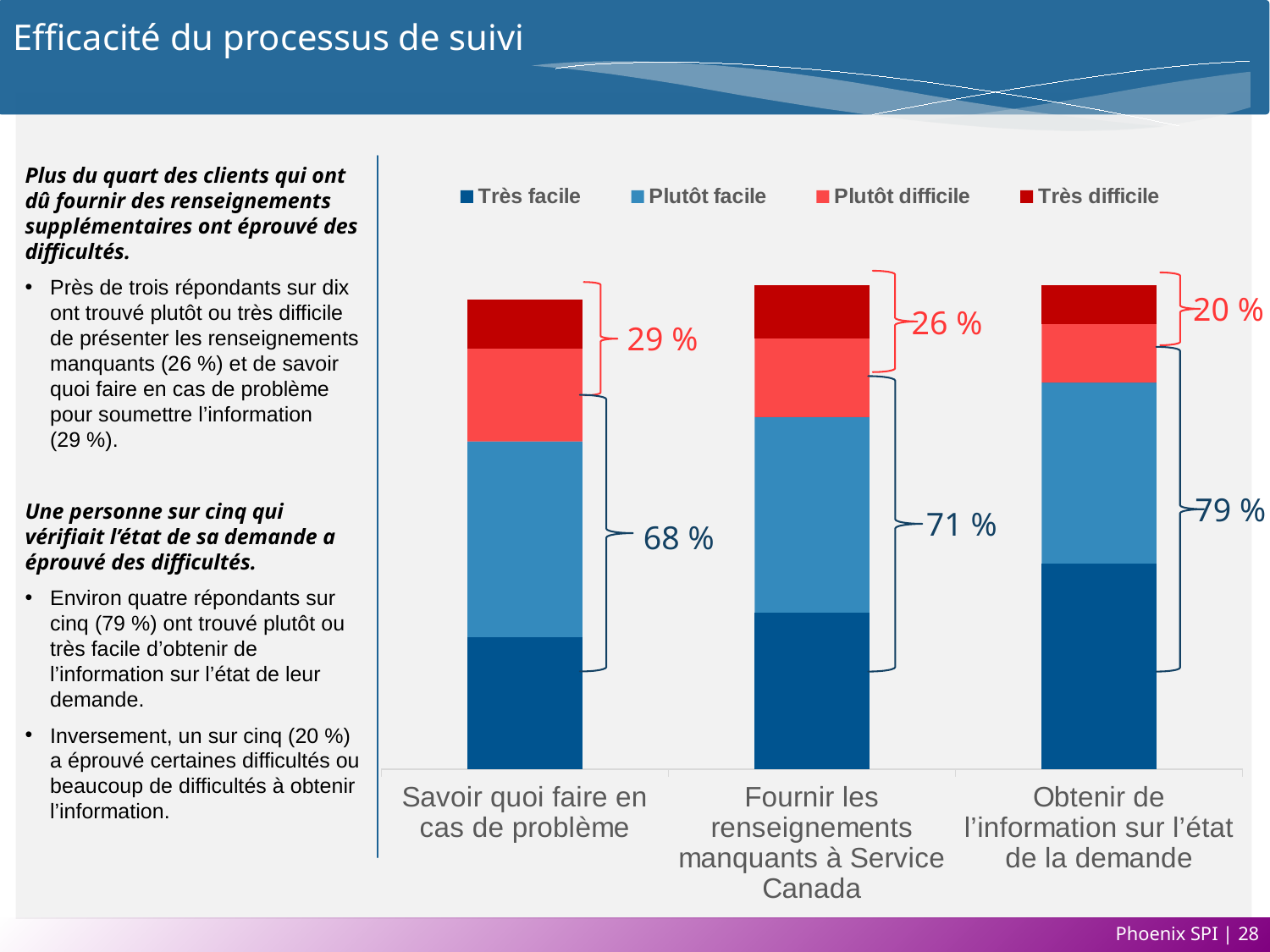
What combined percentage of respondents found it plutôt or très difficile to 'Savoir quoi faire en cas de problème'? 29 % Which legend entry is shown in the darkest red colour? Très difficile What is the difference between the combined 'facile' share for 'Obtenir de l'information sur l'état de la demande' (79 %) and for 'Savoir quoi faire en cas de problème' (68 %)? 11 percentage points What combined percentage of respondents found it plutôt or très facile to 'Fournir les renseignements manquants à Service Canada'? 71 % What combined percentage of respondents found it plutôt or très difficile to 'Obtenir de l'information sur l'état de la demande'? 20 % How many series does the chart legend list? 4 Which is larger: the combined 'facile' share for 'Fournir les renseignements manquants à Service Canada' or for 'Savoir quoi faire en cas de problème'? Fournir les renseignements manquants à Service Canada How many categories are shown on the x axis of the chart? 3 What kind of chart is shown on the slide? Stacked bar chart What is the title of the slide containing the chart? Efficacité du processus de suivi Which category has the highest combined share of respondents finding it plutôt or très facile? Obtenir de l'information sur l'état de la demande Which category has the lowest combined share of respondents finding it plutôt or très difficile? Obtenir de l'information sur l'état de la demande